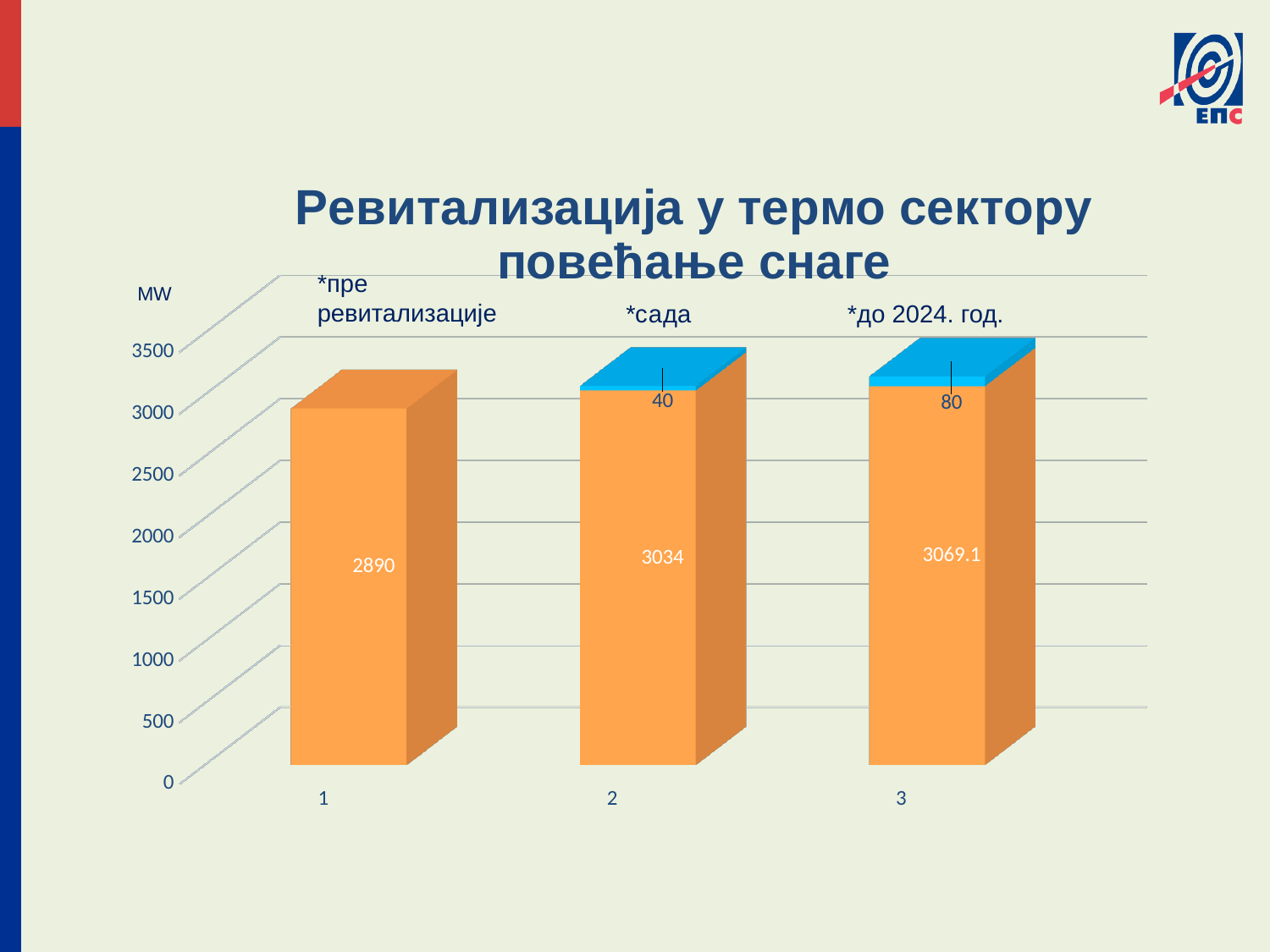
How many categories are shown on the x axis? 3 What is the value of the blue segment for category 2 (*сада)? 40 Which category has the highest orange segment value? 3 (*до 2024. год.) What is the total of the stacked bar for category 3 (*до 2024. год.)? 3149.1 What kind of chart is shown on the slide? Stacked bar chart What is the difference between the orange segment values of category 2 and category 1? 144 What unit is shown on the y axis of the chart? MW What is the value of the blue segment for category 3 (*до 2024. год.)? 80 What is the value of the orange segment for category 1 (*пре ревитализације)? 2890 Which category has the lowest orange segment value? 1 (*пре ревитализације) What is the total of the stacked bar for category 2 (*сада)? 3074 What is the value of the orange segment for category 2 (*сада)? 3034